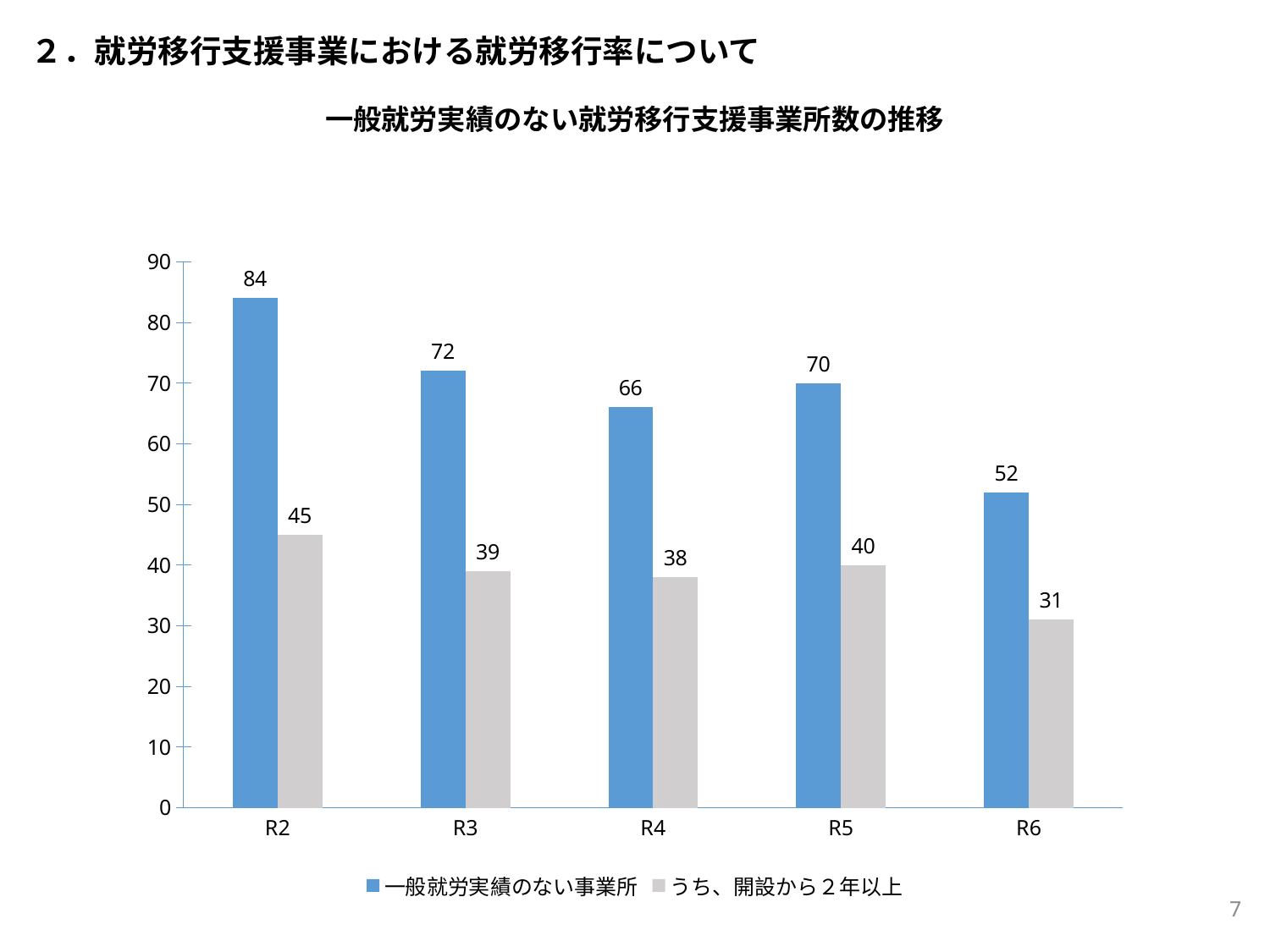
What is the title of the chart? 一般就労実績のない就労移行支援事業所数の推移 What is the difference between 一般就労実績のない事業所 and うち、開設から２年以上 in R5? 30 Which year has the lowest value for うち、開設から２年以上? R6 Which year has the highest value for 一般就労実績のない事業所? R2 What is the value for 一般就労実績のない事業所 in R2? 84 How many series does the legend list? 2 What is the value for 一般就労実績のない事業所 in R4? 66 Does the value for うち、開設から２年以上 rise or fall from R2 to R3? Fall What is the value for うち、開設から２年以上 in R6? 31 What kind of chart is shown on the slide? Bar chart Which is larger: 一般就労実績のない事業所 in R3 or in R5? R3 How many years are shown on the x axis? 5